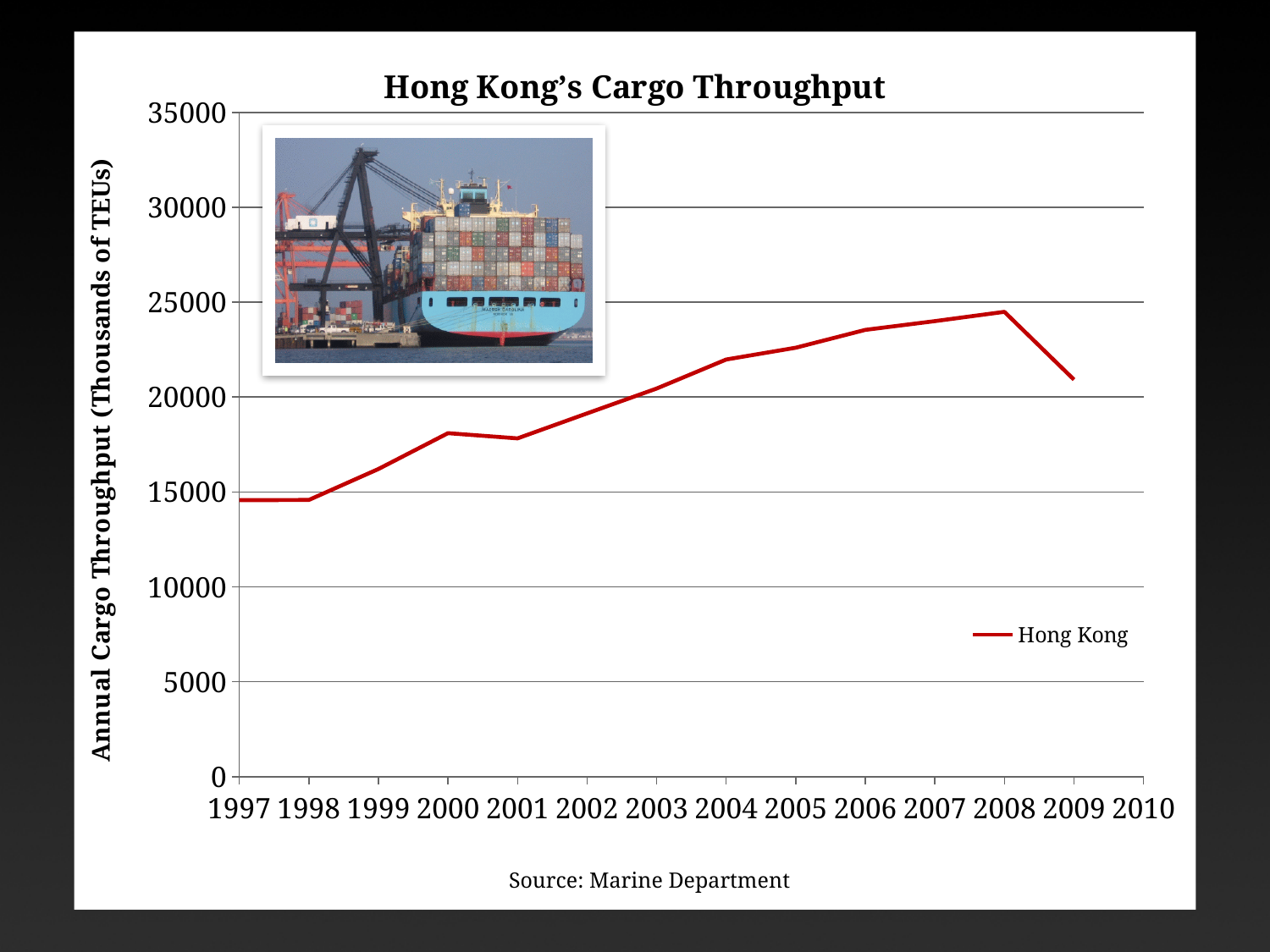
In which year is Hong Kong's cargo throughput highest? 2008 What kind of chart is shown on the slide? Line chart Does the cargo throughput rise or fall between 1998 and 2008? Rise Does the cargo throughput rise or fall between 2008 and 2009? Fall Is the value for 2008 greater or less than 25000? less How many series does the legend list? 1 Is the value for 1997 greater or less than 15000? less Is the value for 2002 greater or less than 20000? less What is the label on the vertical axis? Annual Cargo Throughput (Thousands of TEUs) What is the title of the chart? Hong Kong's Cargo Throughput Which year has the larger cargo throughput, 2008 or 2009? 2008